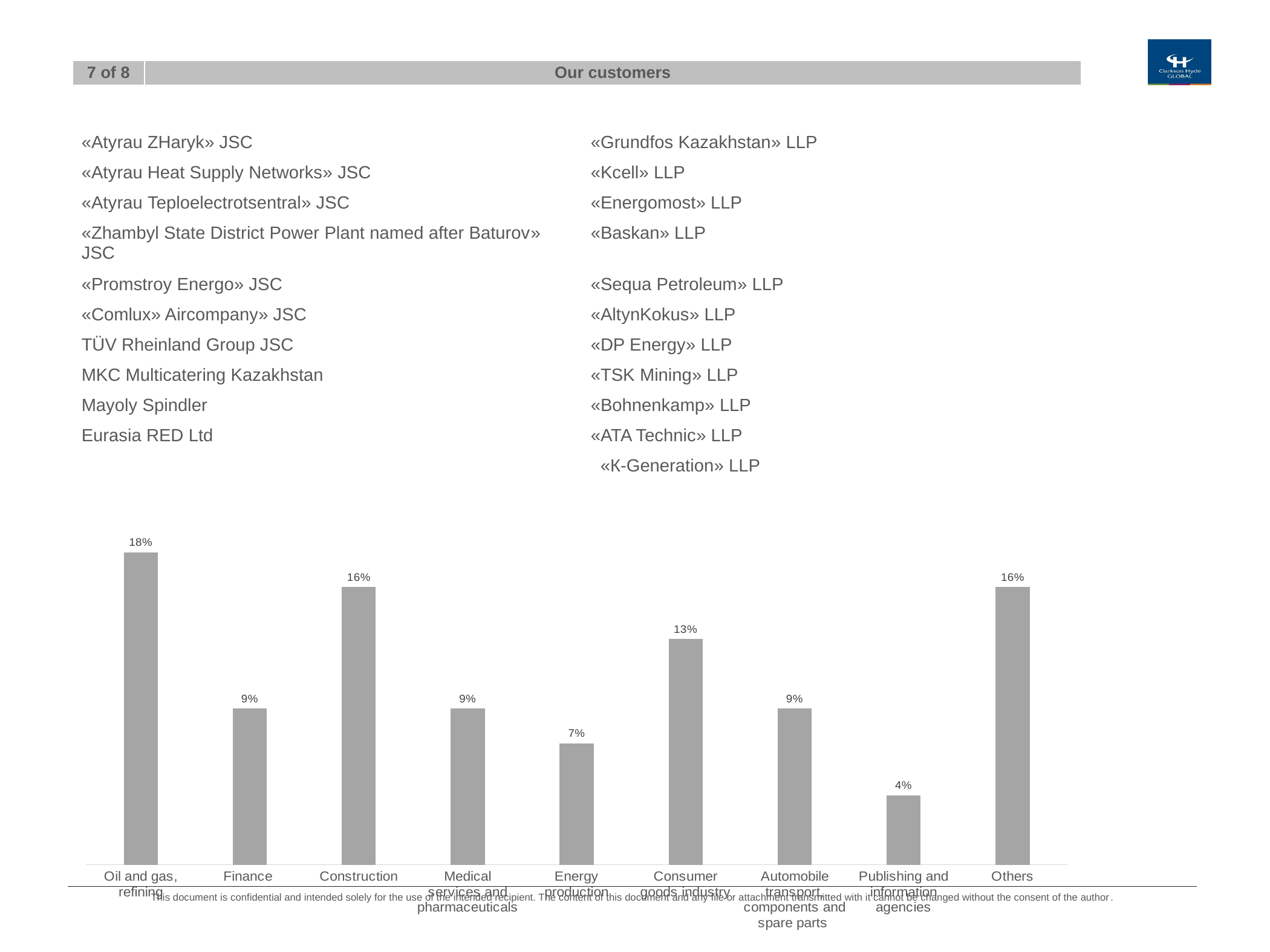
What is the value for Energy production? 7% What is the value for Publishing and information agencies? 4% Which category has the lowest value? Publishing and information agencies Which category has the highest value? Oil and gas, refining What is the difference between the values for Consumer goods industry and Energy production? 6% What is the difference between the values for Oil and gas, refining and Construction? 2% Which is larger, the value for Construction or the value for Consumer goods industry? Construction What is the value for Others? 16% What kind of chart is shown on the slide? Bar chart What is the value for Oil and gas, refining? 18% How many categories are shown in the bar chart? 9 What is the value for Consumer goods industry? 13%